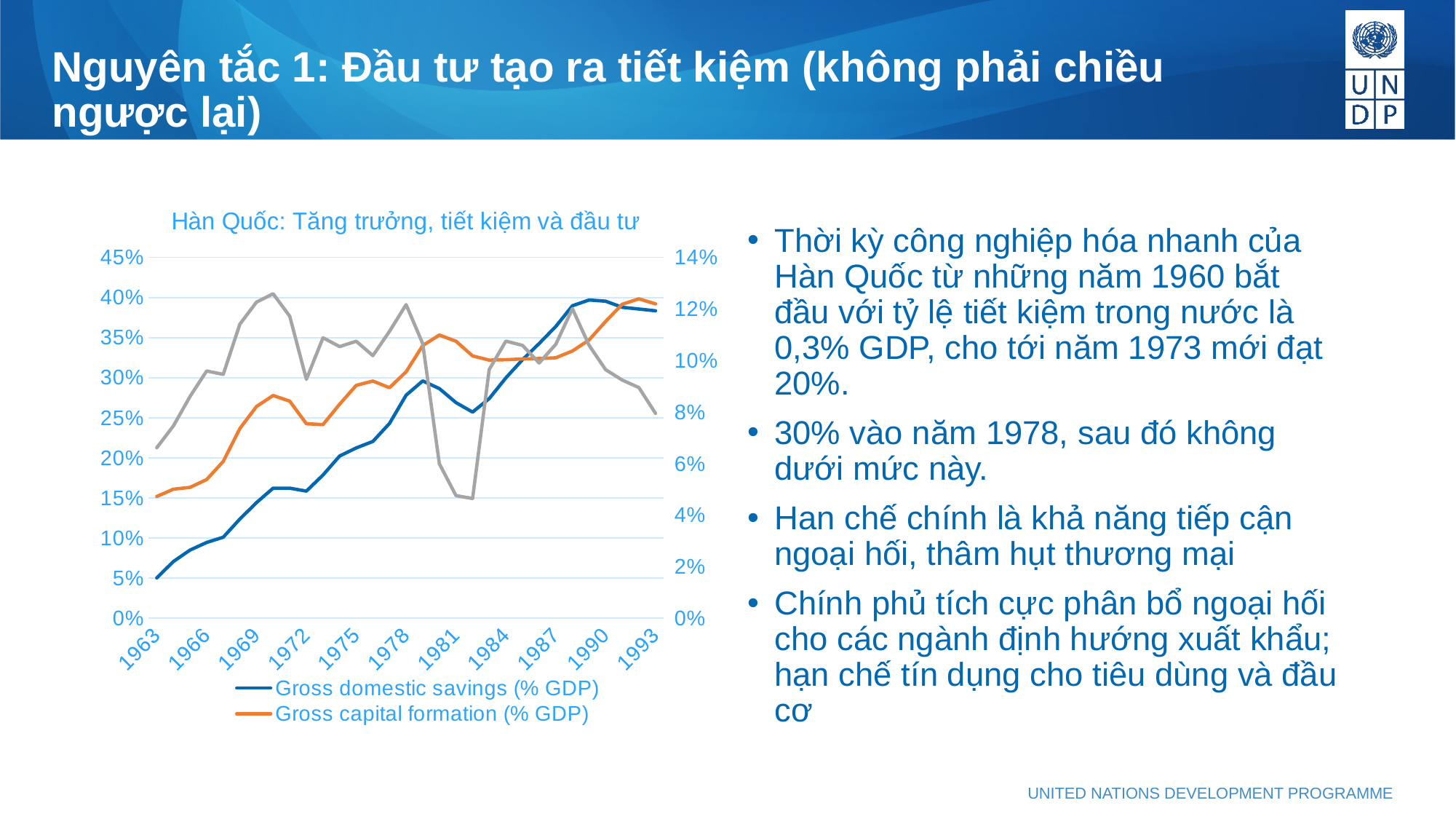
Is the value for Gross domestic savings (% GDP) in 1993 greater or less than 35%? greater What kind of chart is shown on the slide? line chart Does the Gross domestic savings (% GDP) line generally rise or fall from 1963 to 1978? rise What is the highest value shown on the left vertical axis? 45% In 1963, which is larger: Gross domestic savings (% GDP) or Gross capital formation (% GDP)? Gross capital formation (% GDP) Is the value for Gross domestic savings (% GDP) in 1963 greater or less than 10%? less What is the title of the chart? Hàn Quốc: Tăng trưởng, tiết kiệm và đầu tư Is the value for Gross capital formation (% GDP) in 1963 greater or less than 10%? greater In 1990, which is larger: Gross domestic savings (% GDP) or Gross capital formation (% GDP)? Gross domestic savings (% GDP) How many series does the chart legend list? 2 How many year labels are shown on the x axis? 11